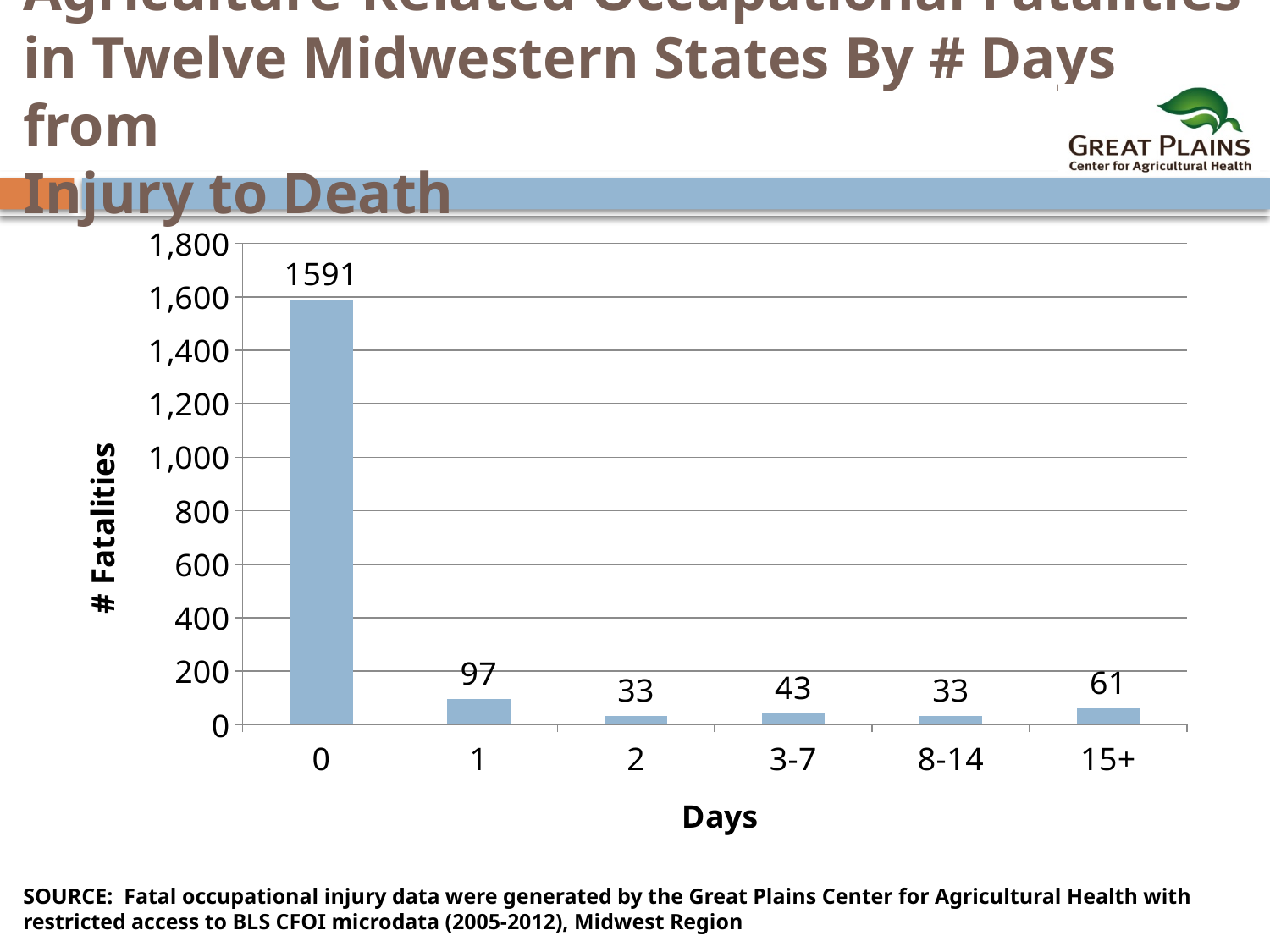
What is the label of the y axis? # Fatalities What is the difference in fatalities between the 15+ and 3-7 days categories? 18 How many days categories are shown on the x axis? 6 Which days category has the highest number of fatalities? 0 What is the number of fatalities for the 1 day category? 97 What is the number of fatalities for the 15+ days category? 61 What kind of chart is shown on the slide? bar chart What is the number of fatalities for the 3-7 days category? 43 Which has more fatalities, the 1 day category or the 15+ days category? 1 What is the difference in fatalities between the 0 days and 1 day categories? 1494 Is the value for the 0 days category greater or less than 1,400? greater How many fatalities occurred 0 days from injury to death? 1591